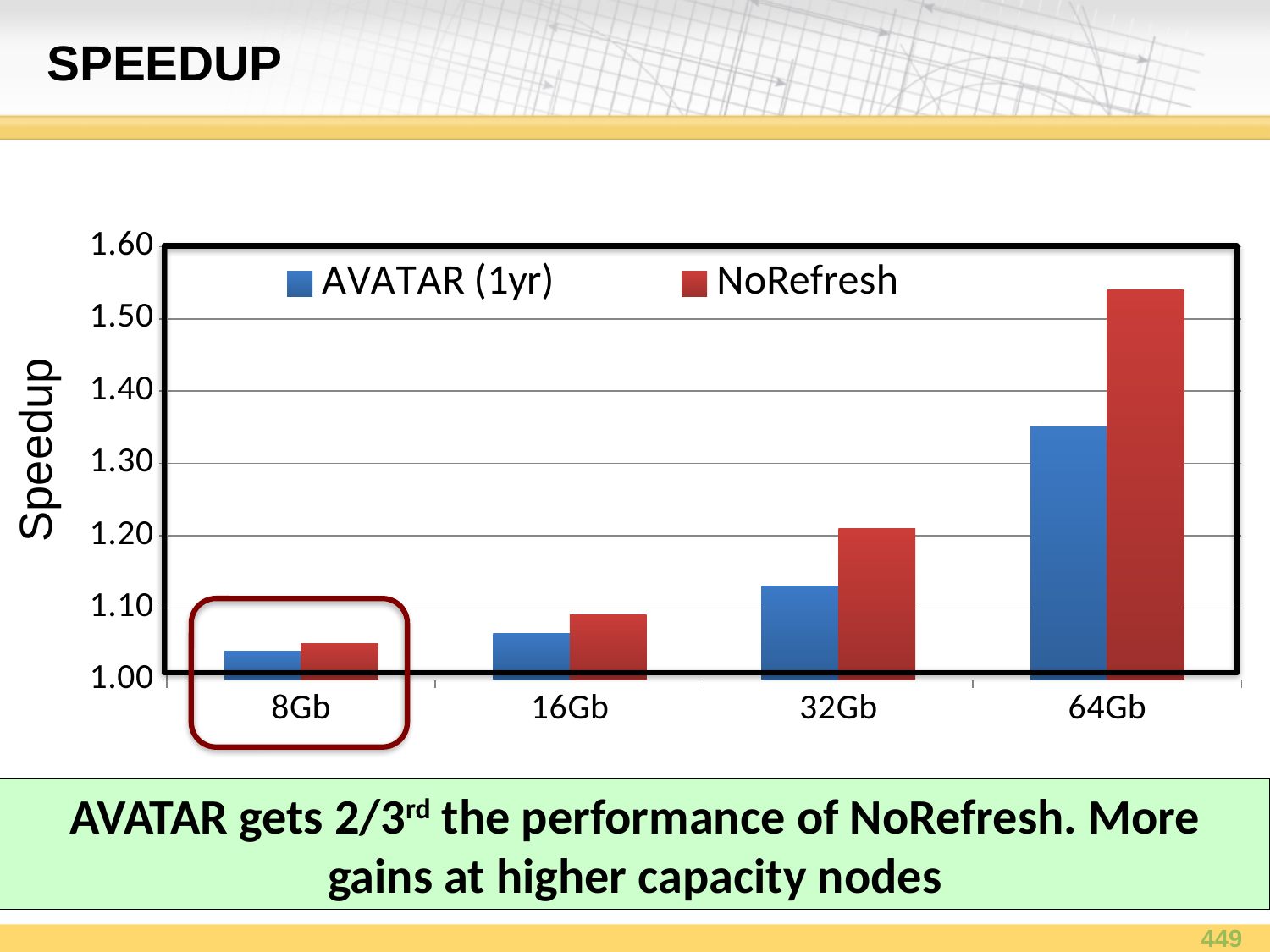
At 32Gb, which series has the larger speedup, AVATAR (1yr) or NoRefresh? NoRefresh Is the NoRefresh speedup for 64Gb greater or less than 1.50? greater Which capacity has the lowest AVATAR (1yr) speedup? 8Gb Which capacity has the highest NoRefresh speedup? 64Gb Do the NoRefresh speedup values rise or fall as capacity increases from 8Gb to 64Gb? rise Is the AVATAR (1yr) speedup for 16Gb greater or less than 1.10? less What is the label on the y axis of the chart? Speedup How many capacity categories are shown on the x axis? 4 What kind of chart is shown on the slide? bar chart Is the AVATAR (1yr) speedup for 64Gb greater or less than 1.40? less How many series does the legend list? 2